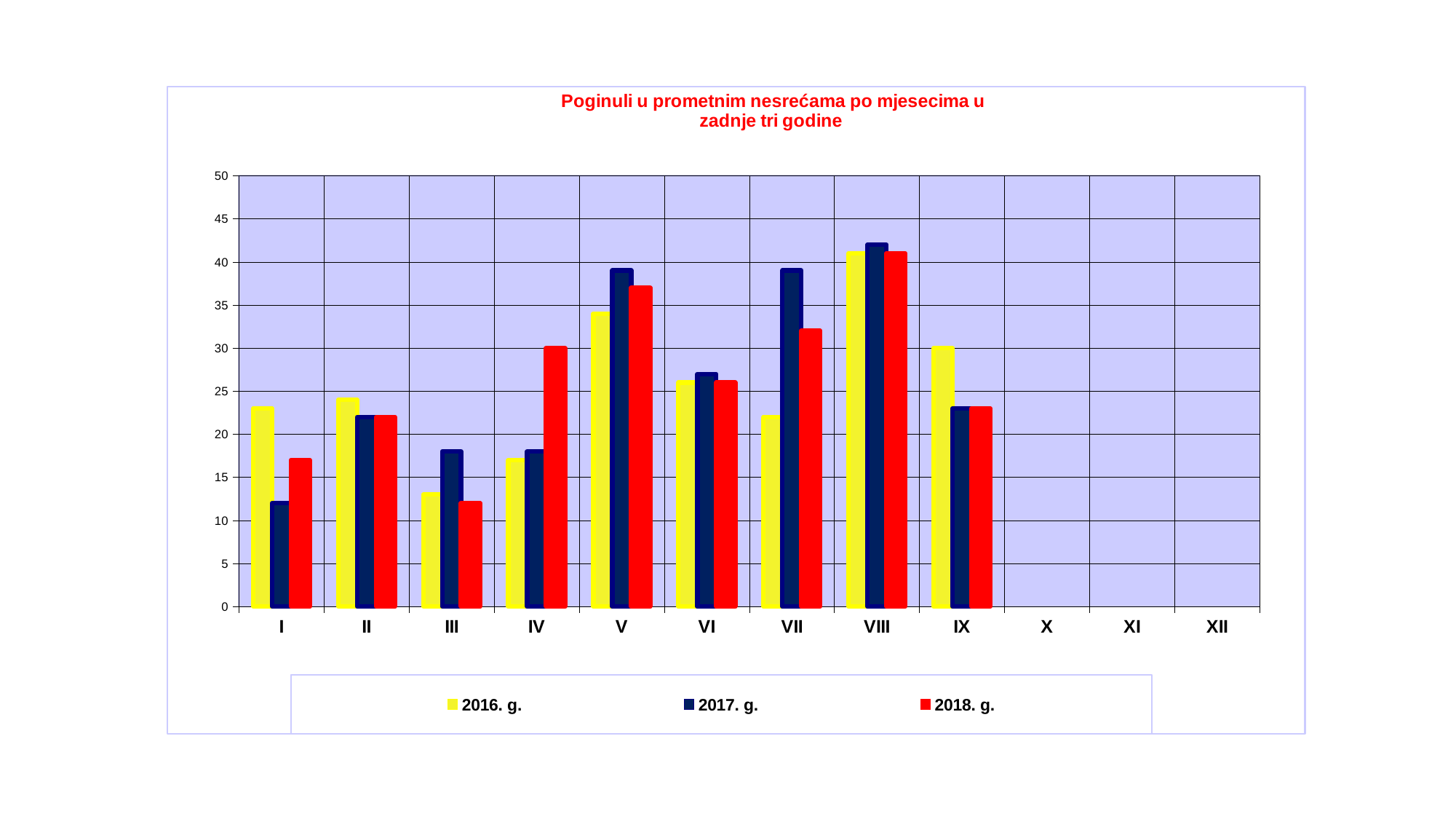
Is the value for 2017. g. in month I greater or less than 15? less In which month is the value for 2018. g. highest? VIII For how many months are bars plotted? 9 In which month is the value for 2017. g. highest? VIII How many month categories are labelled on the x axis? 12 In month IV, which series has the larger value, 2016. g. or 2018. g.? 2018. g. Is the value for 2017. g. in month VII greater or less than 35? greater In which month is the value for 2017. g. lowest? I What is the title of the chart? Poginuli u prometnim nesrećama po mjesecima u zadnje tri godine In which month is the value for 2016. g. lowest? III How many series does the legend list? 3 What kind of chart is shown on the slide? bar chart